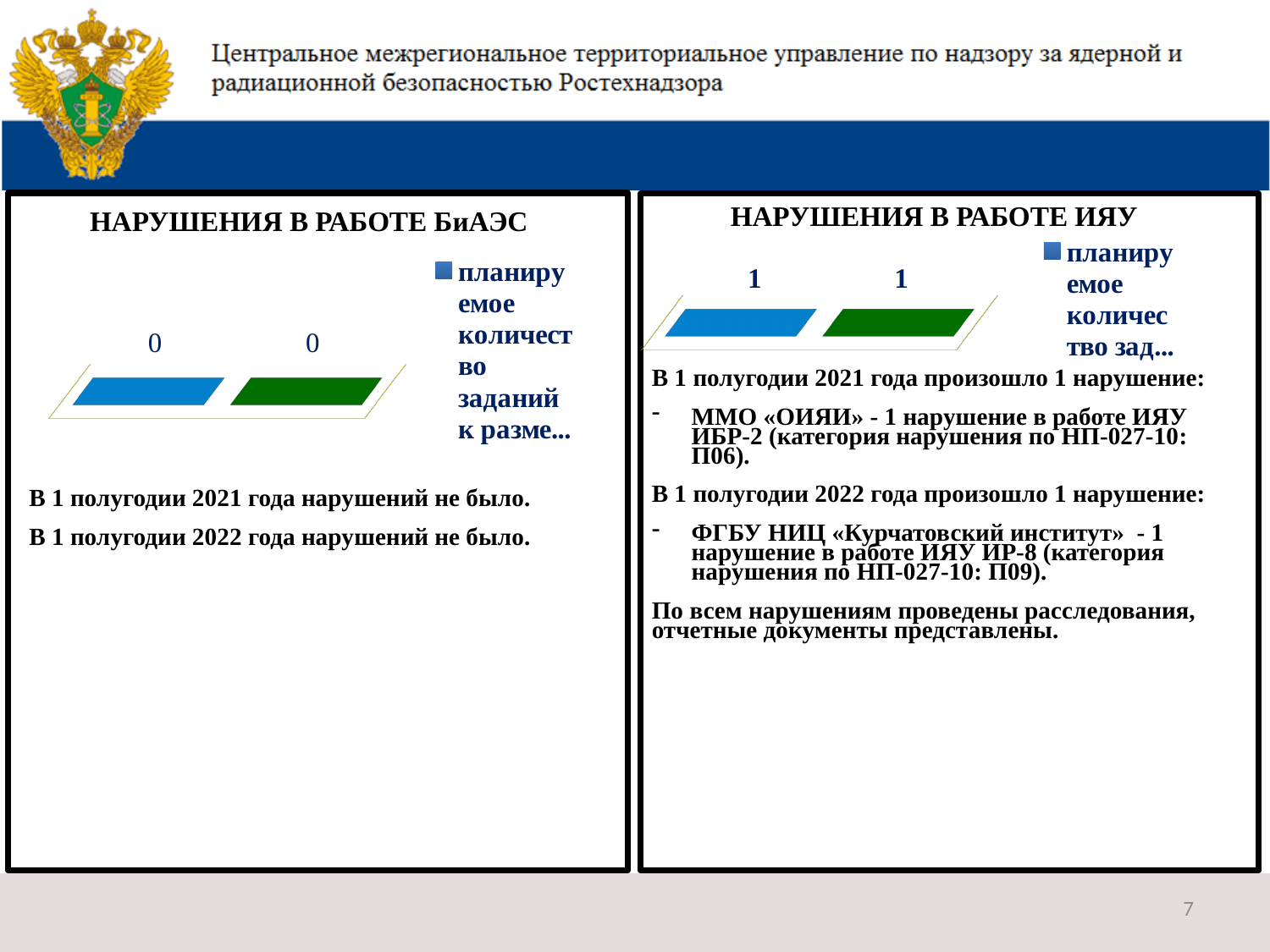
How many bars are plotted in the chart titled "НАРУШЕНИЯ В РАБОТЕ БиАЭС" on the left? 2 In the chart titled "НАРУШЕНИЯ В РАБОТЕ ИЯУ" on the right, what value is printed above the green bar? 1 In the chart titled "НАРУШЕНИЯ В РАБОТЕ БиАЭС" on the left, what value is printed above the blue bar? 0 In the chart titled "НАРУШЕНИЯ В РАБОТЕ БиАЭС" on the left, what value is printed above the green bar? 0 How many entries does the legend of the chart titled "НАРУШЕНИЯ В РАБОТЕ БиАЭС" on the left list? 1 What two colours are the bars in the chart titled "НАРУШЕНИЯ В РАБОТЕ ИЯУ" on the right? Blue and green How many bars are plotted in the chart titled "НАРУШЕНИЯ В РАБОТЕ ИЯУ" on the right? 2 What kind of chart is the chart titled "НАРУШЕНИЯ В РАБОТЕ БиАЭС" on the left? Bar chart What is the title of the chart on the left side of the slide? НАРУШЕНИЯ В РАБОТЕ БиАЭС In the chart titled "НАРУШЕНИЯ В РАБОТЕ ИЯУ" on the right, what is the difference between the values of the blue bar and the green bar? 0 What kind of chart is the chart titled "НАРУШЕНИЯ В РАБОТЕ ИЯУ" on the right? Bar chart In the chart titled "НАРУШЕНИЯ В РАБОТЕ ИЯУ" on the right, what value is printed above the blue bar? 1